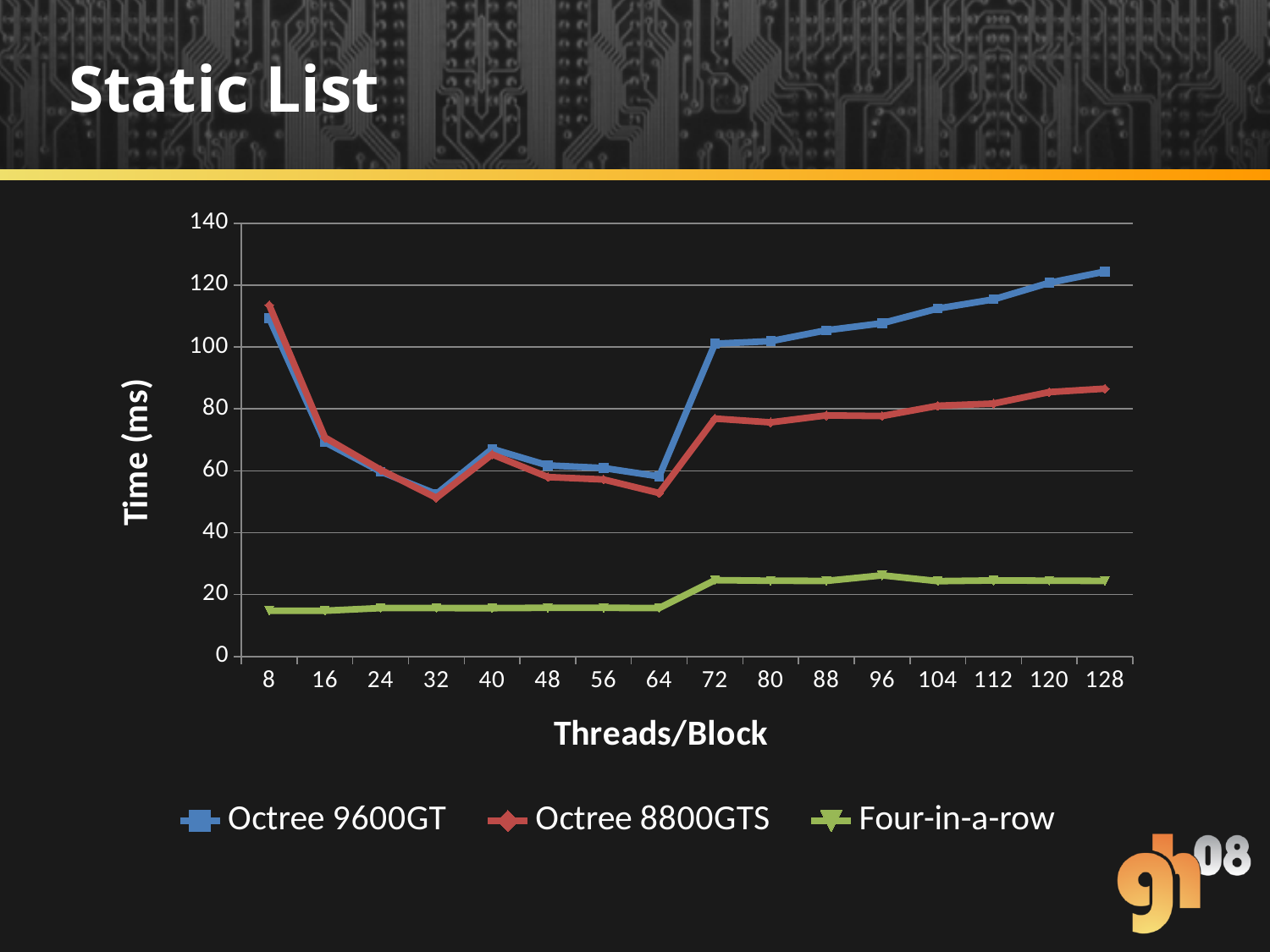
Is the value for Four-in-a-row at 8 Threads/Block greater or less than 20? less How many series does the legend list? 3 At 128 Threads/Block, which series has the larger value, Octree 9600GT or Octree 8800GTS? Octree 9600GT What is the title of the y axis? Time (ms) At which Threads/Block value does Octree 9600GT reach its highest time? 128 How many Threads/Block values are plotted along the x axis? 16 Is the value for Octree 9600GT at 128 Threads/Block greater or less than 120? greater Is the value for Octree 8800GTS at 8 Threads/Block greater or less than 100? greater Which series has the lowest values across all Threads/Block settings? Four-in-a-row Do the values for Octree 9600GT rise or fall from 72 to 128 Threads/Block? rise What kind of chart is shown on the slide? line chart